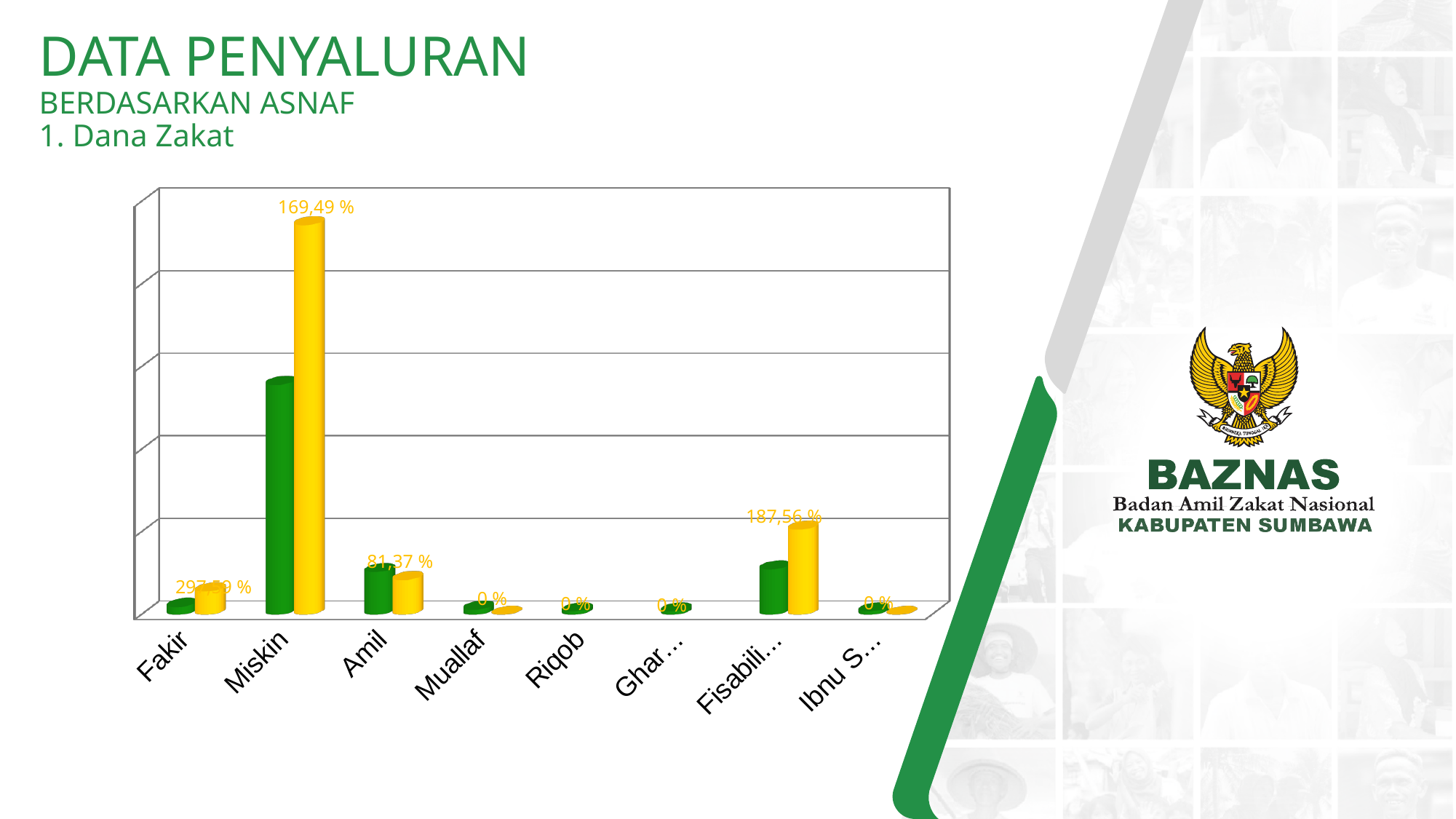
What two colours are used for the bars in the chart? green and yellow How many categories are shown along the x axis of the chart? 8 What is the difference between the labelled percentages for Miskin and Amil? 88,12 % Which has the taller yellow bar, Miskin or Amil? Miskin What percentage is labelled for Muallaf in the chart? 0 % What kind of chart is shown on the slide? bar chart How many categories in the chart are labelled 0 %? 4 What percentage is labelled for Miskin in the chart? 169,49 % What is the main title of the slide above the chart? DATA PENYALURAN What percentage is labelled for Amil in the chart? 81,37 % What percentage is labelled for Riqob in the chart? 0 % Which category has the tallest bar in the chart? Miskin